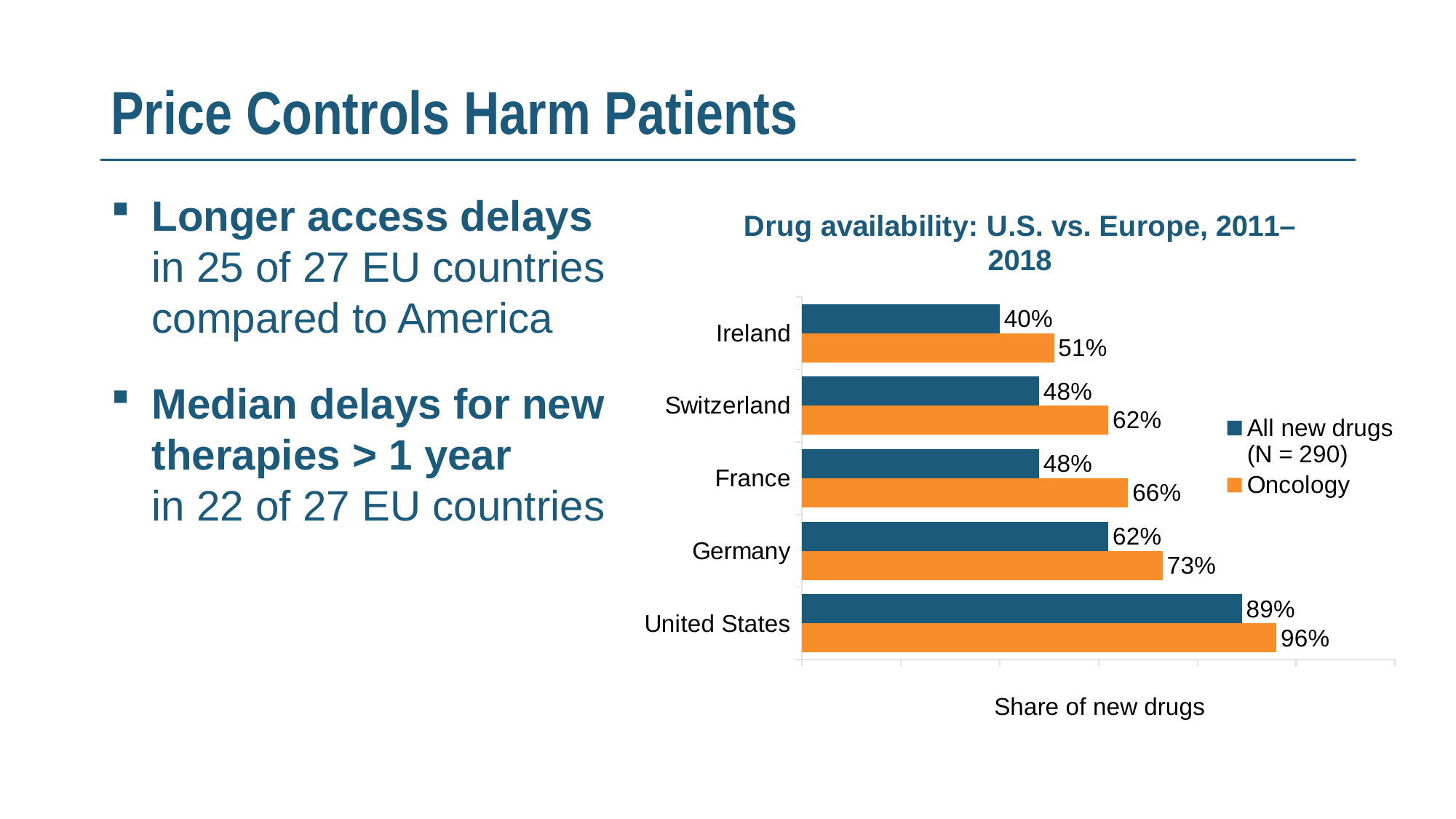
Which is larger, the Oncology value for Germany or the Oncology value for Switzerland? Germany Which country has the lowest value for All new drugs (N = 290)? Ireland How many countries are shown in the chart? 5 What is the difference between the Oncology value and the All new drugs value for Switzerland? 14% Which country has the highest Oncology value? United States What kind of chart is shown on the slide? Bar chart What is the title of the chart? Drug availability: U.S. vs. Europe, 2011–2018 How many series does the legend list? 2 What is the value for All new drugs (N = 290) for Germany? 62% What is the Oncology value for France? 66% What is the value for All new drugs (N = 290) for Ireland? 40% What is the Oncology value for the United States? 96%